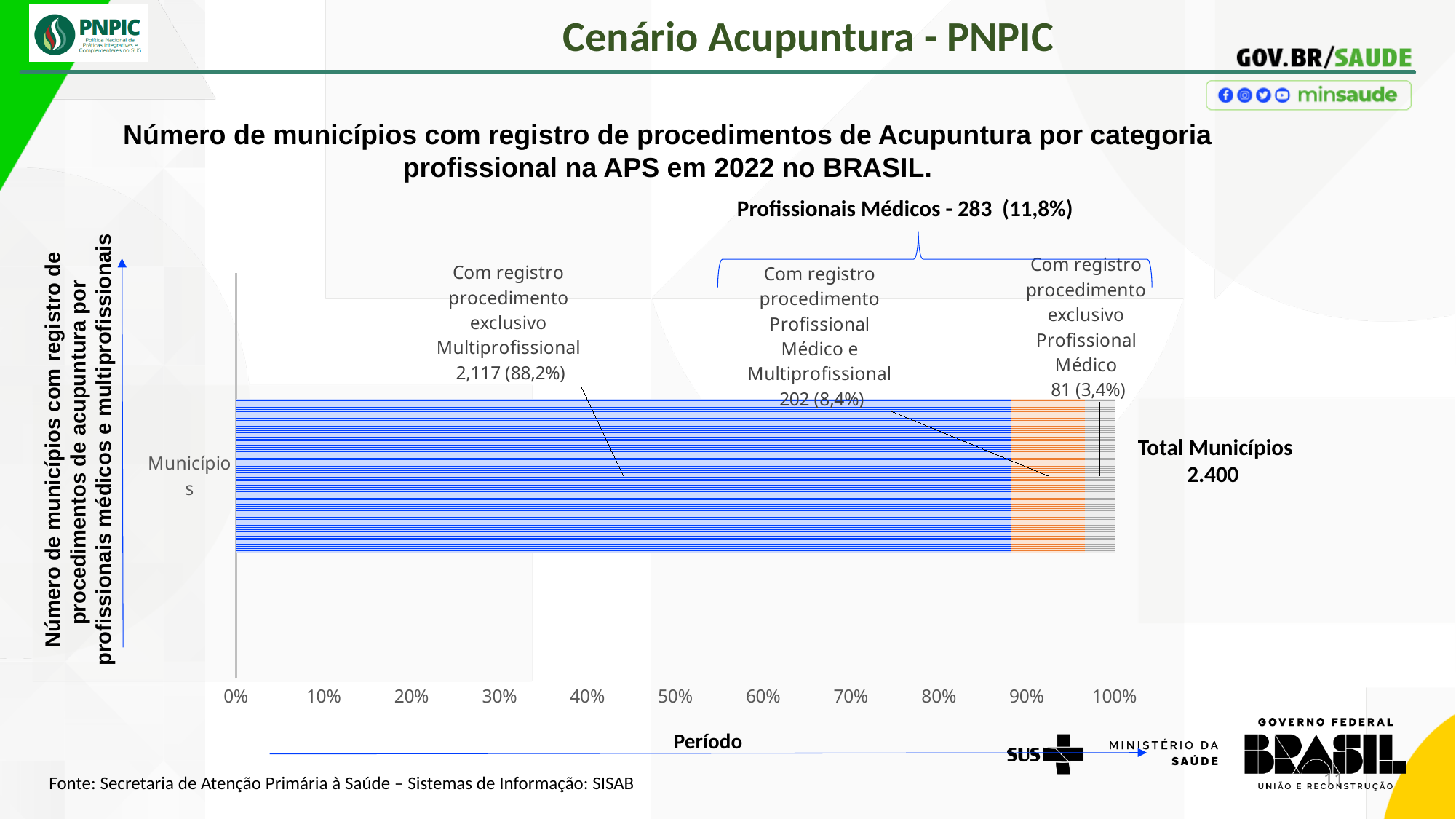
What is the difference in municipalities between the 'Profissional Médico e Multiprofissional' segment and the 'exclusivo Profissional Médico' segment? 121 What percentage is shown for the segment 'Com registro procedimento exclusivo Multiprofissional'? 88,2% How many municipalities are in the segment 'Com registro procedimento Profissional Médico e Multiprofissional'? 202 Which segment of the bar has the highest number of municipalities? Com registro procedimento exclusivo Multiprofissional How many municipalities are in the segment 'Com registro procedimento exclusivo Multiprofissional'? 2,117 Which segment of the bar has the lowest number of municipalities? Com registro procedimento exclusivo Profissional Médico What percentage is shown for the segment 'Com registro procedimento exclusivo Profissional Médico'? 3,4% What is the total number of municipalities shown for the bar? 2.400 What value and percentage are given for 'Profissionais Médicos' above the chart? 283 (11,8%) What kind of chart is shown on the slide? bar chart What is the label of the x axis of the chart? Período How many municipalities are in the segment 'Com registro procedimento exclusivo Profissional Médico'? 81